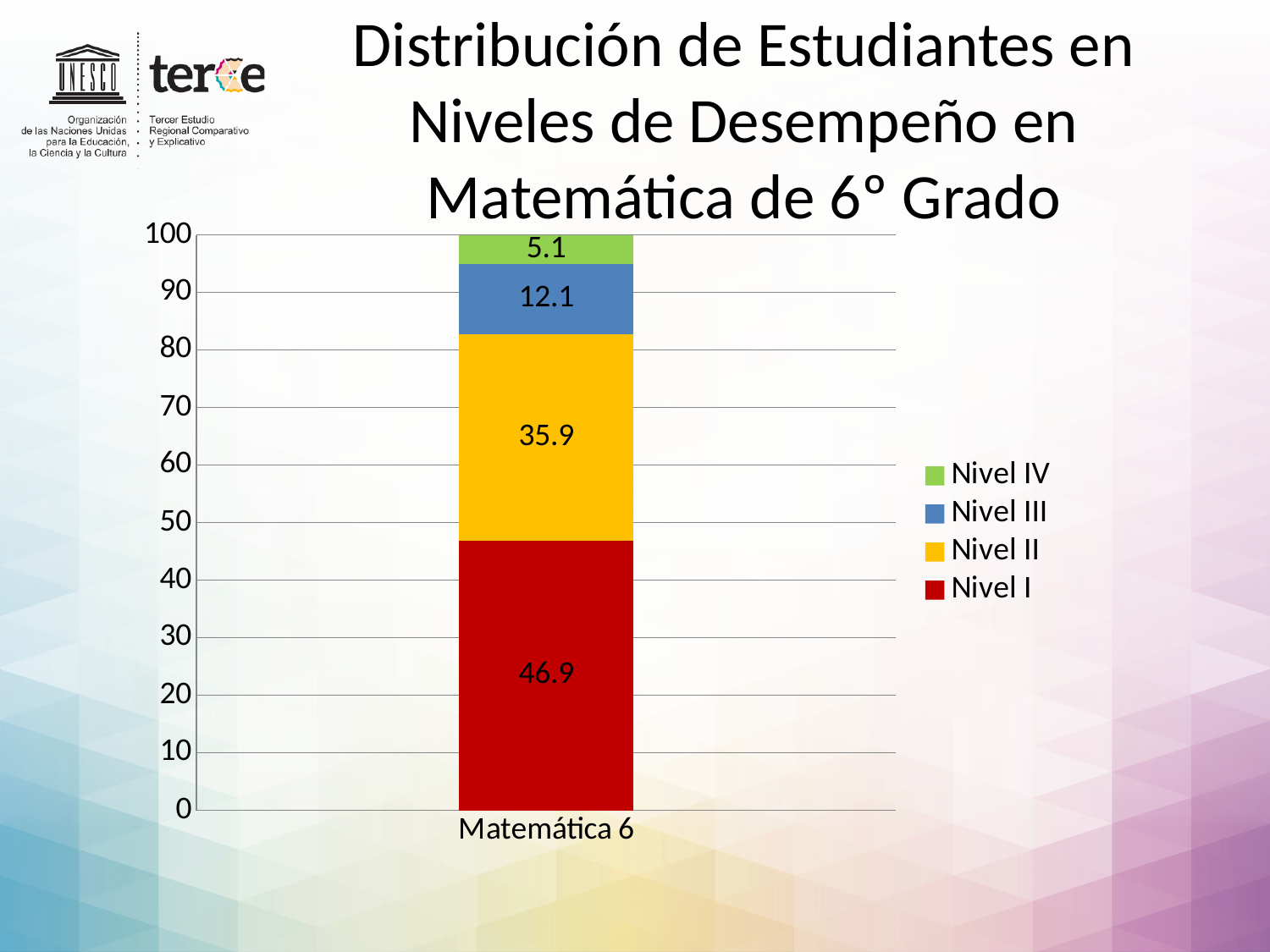
Which is larger, the value for Nivel III or the value for Nivel IV? Nivel III Which level has the largest share of students in the Matemática 6 bar? Nivel I Which level has the smallest share of students in the Matemática 6 bar? Nivel IV What is the value for Nivel I in the Matemática 6 bar? 46.9 What colour represents Nivel II in the chart? Yellow What is the value for Nivel II in the Matemática 6 bar? 35.9 How many series does the legend list? 4 What is the value for Nivel IV in the Matemática 6 bar? 5.1 What is the value for Nivel III in the Matemática 6 bar? 12.1 What is the total of the stacked Matemática 6 bar? 100 What is the difference between the Nivel I and Nivel II values? 11 What kind of chart is shown on the slide? Stacked bar chart